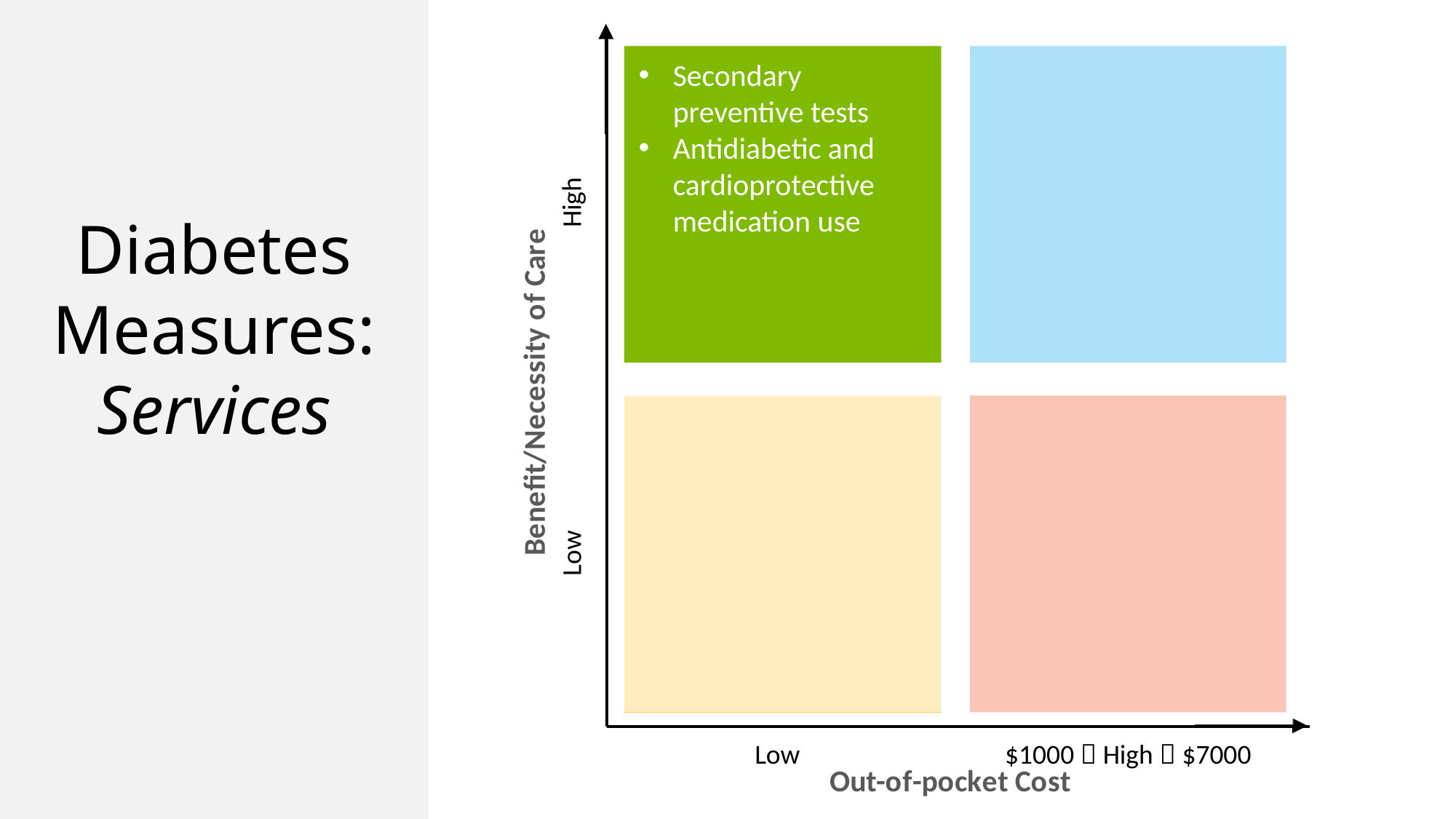
What two dollar amounts are printed on the horizontal axis under the High cost side? $1000 and $7000 How many of the four quadrants contain listed items? 1 What is the label of the vertical axis? Benefit/Necessity of Care What is the label of the horizontal axis? Out-of-pocket Cost Which quadrant lists 'Antidiabetic and cardioprotective medication use'? High benefit/necessity, low out-of-pocket cost How many quadrants does the matrix contain? 4 How many items are listed in the green (high benefit, low cost) quadrant? 2 In which quadrant does 'Secondary preventive tests' appear? High benefit/necessity, low out-of-pocket cost What kind of chart is shown on the slide? A 2x2 quadrant matrix